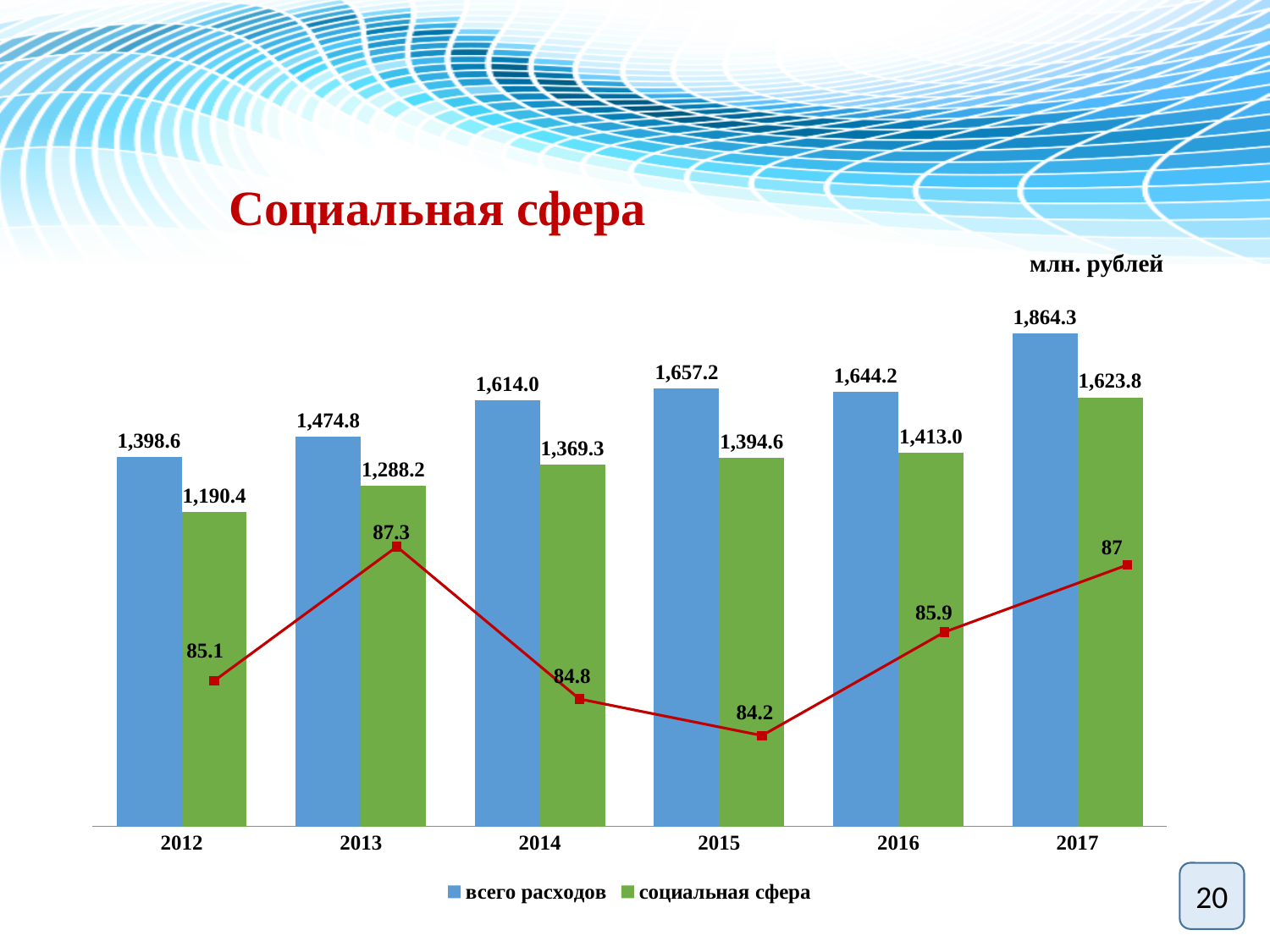
What kind of chart is shown on the slide? a bar chart with a line overlaid (combined bar and line chart) How many years are shown on the x axis? 6 How many series does the legend list? 2 In which year does the red line reach its lowest value? 2015 In which year is социальная сфера the lowest? 2012 What is the difference between всего расходов and социальная сфера in 2017? 240.5 What is the value of всего расходов for 2014? 1,614.0 What value does the red line show for 2013? 87.3 Which is larger, всего расходов in 2015 or in 2016? 2015 What is the value of социальная сфера for 2016? 1,413.0 Do the values for социальная сфера rise or fall from 2012 to 2017? rise In which year is всего расходов the highest? 2017